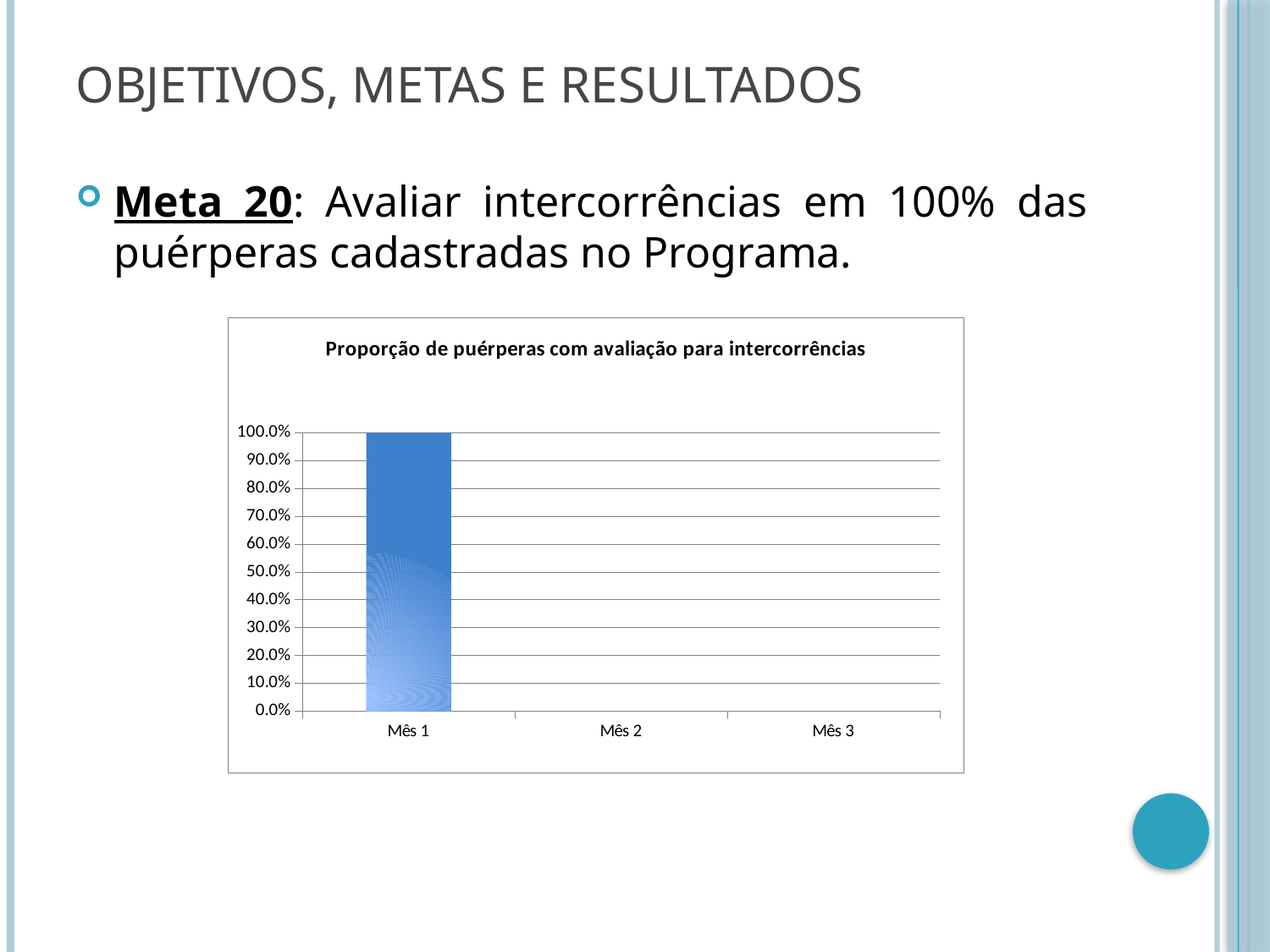
Which is larger, the value for Mês 1 or the value for Mês 2? Mês 1 Is the value for Mês 2 greater or less than 10.0%? less What is the title of the chart? Proporção de puérperas com avaliação para intercorrências Is the value for Mês 3 greater or less than 10.0%? less What is the value for Mês 1 in the chart? 100.0% How many categories are shown on the x axis of the chart? 3 Which category has the highest value in the chart? Mês 1 What type of chart is shown on the slide? bar chart Which is larger, the value for Mês 1 or the value for Mês 3? Mês 1 Is the value for Mês 1 greater or less than 90.0%? greater What is the label of the first category on the x axis? Mês 1 Do the values rise or fall from Mês 1 to Mês 3? fall